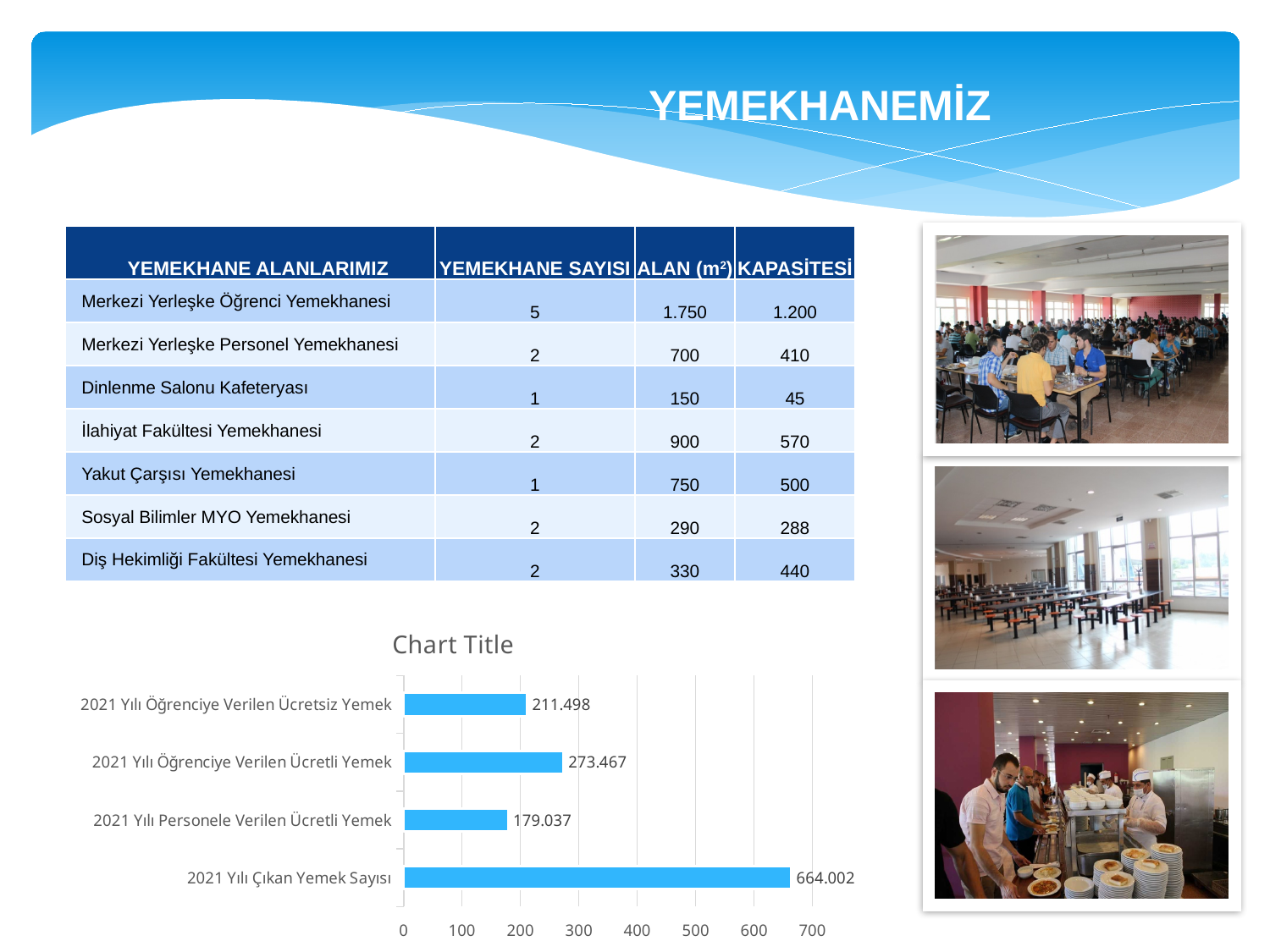
Which is larger: the value for 2021 Yılı Öğrenciye Verilen Ücretli Yemek or the value for 2021 Yılı Öğrenciye Verilen Ücretsiz Yemek? 2021 Yılı Öğrenciye Verilen Ücretli Yemek What is the value for 2021 Yılı Öğrenciye Verilen Ücretsiz Yemek? 211.498 What kind of chart is shown on the slide? bar chart How many categories are shown in the chart? 4 What is the value for 2021 Yılı Personele Verilen Ücretli Yemek? 179.037 Which category has the highest value? 2021 Yılı Çıkan Yemek Sayısı What is the title of the chart? Chart Title What is the difference between the values for 2021 Yılı Öğrenciye Verilen Ücretli Yemek and 2021 Yılı Personele Verilen Ücretli Yemek? 94.430 What is the value for 2021 Yılı Öğrenciye Verilen Ücretli Yemek? 273.467 Which category has the lowest value? 2021 Yılı Personele Verilen Ücretli Yemek What is the value for 2021 Yılı Çıkan Yemek Sayısı? 664.002 What is the difference between the values for 2021 Yılı Çıkan Yemek Sayısı and 2021 Yılı Öğrenciye Verilen Ücretsiz Yemek? 452.504